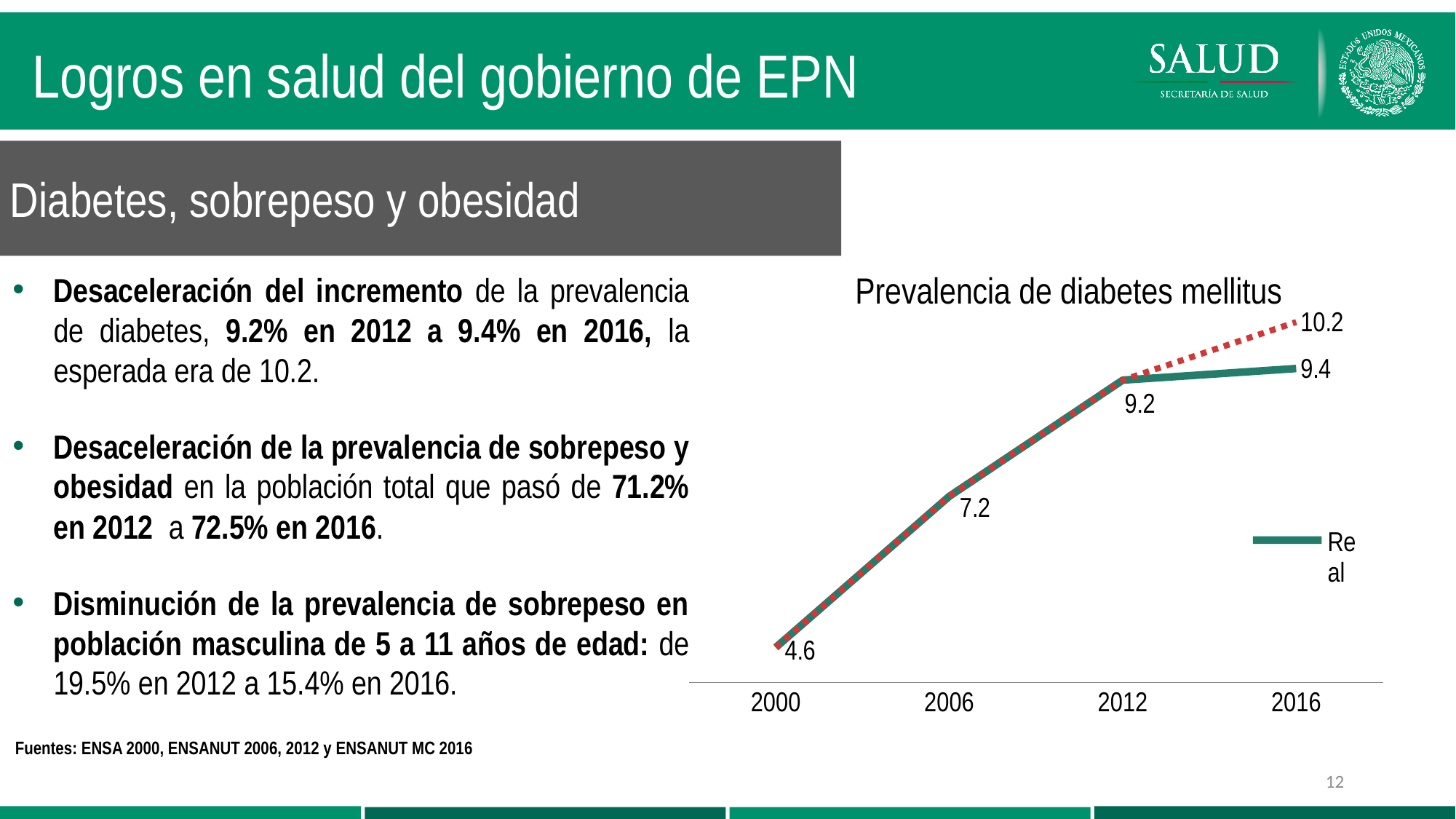
What type of chart is shown on the slide? line chart What is the value plotted for 2006? 7.2 What is the value plotted for 2000? 4.6 What is the difference between the values for 2012 and 2006? 2.0 Which is larger in 2016, the dotted line value or the solid 'Real' line value? the dotted line value What is the value plotted for 2012? 9.2 How many years are shown on the x axis? 4 What is the value of the solid 'Real' line in 2016? 9.4 Does the solid 'Real' line rise or fall from 2000 to 2016? rise What is the value of the dotted line in 2016? 10.2 What is the difference between the dotted line value and the 'Real' line value in 2016? 0.8 What is the title of the chart? Prevalencia de diabetes mellitus